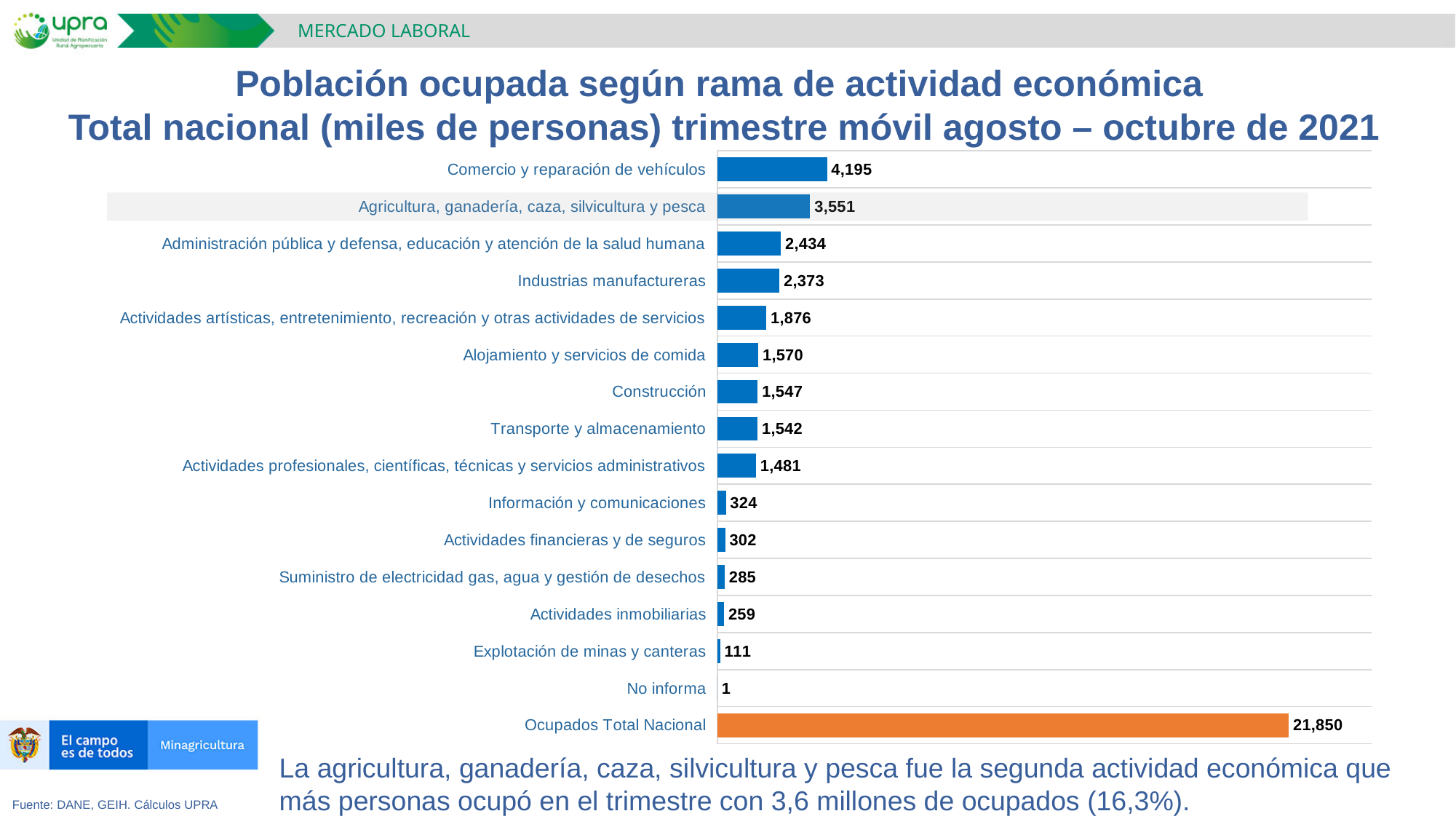
Excluding the Ocupados Total Nacional bar, which category has the highest value? Comercio y reparación de vehículos What is the difference between the values for Comercio y reparación de vehículos and Agricultura, ganadería, caza, silvicultura y pesca? 644 How many bars are plotted in the chart, including the Ocupados Total Nacional bar? 16 What is the value for Explotación de minas y canteras? 111 Which category has the lowest value? No informa Which is larger, the value for Información y comunicaciones or the value for Explotación de minas y canteras? Información y comunicaciones What colour is the bar for Ocupados Total Nacional? Orange What is the difference between the values for Administración pública y defensa, educación y atención de la salud humana and Industrias manufactureras? 61 What is the value for Comercio y reparación de vehículos? 4,195 What kind of chart is shown on the slide? Bar chart What is the value for Agricultura, ganadería, caza, silvicultura y pesca? 3,551 What is the value for Ocupados Total Nacional? 21,850